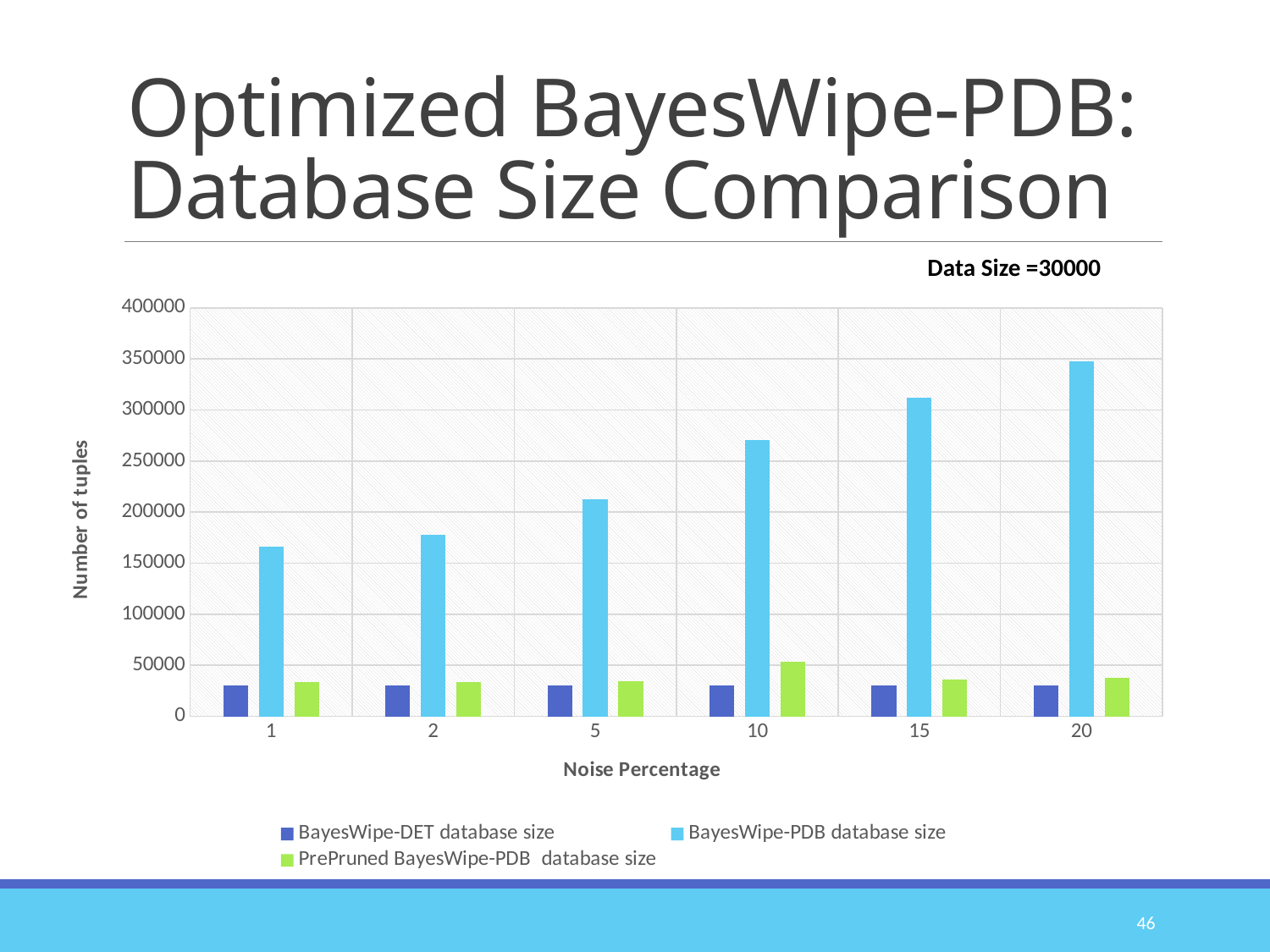
Is the BayesWipe-DET database size at noise percentage 10 greater or less than 50000? less At which noise percentage is the BayesWipe-PDB database size highest? 20 Which is larger at noise percentage 10: the BayesWipe-PDB database size or the PrePruned BayesWipe-PDB database size? BayesWipe-PDB database size At which noise percentage is the BayesWipe-PDB database size lowest? 1 What is the label of the y axis? Number of tuples What kind of chart is shown on the slide? bar chart What data size is stated above the chart? Data Size =30000 How many noise percentage categories are shown on the x axis? 6 How many series does the legend list? 3 Is the BayesWipe-PDB database size at noise percentage 20 greater or less than 300000? greater Is the BayesWipe-PDB database size at noise percentage 1 greater or less than 200000? less Do the BayesWipe-PDB database size values rise or fall as the noise percentage increases? rise